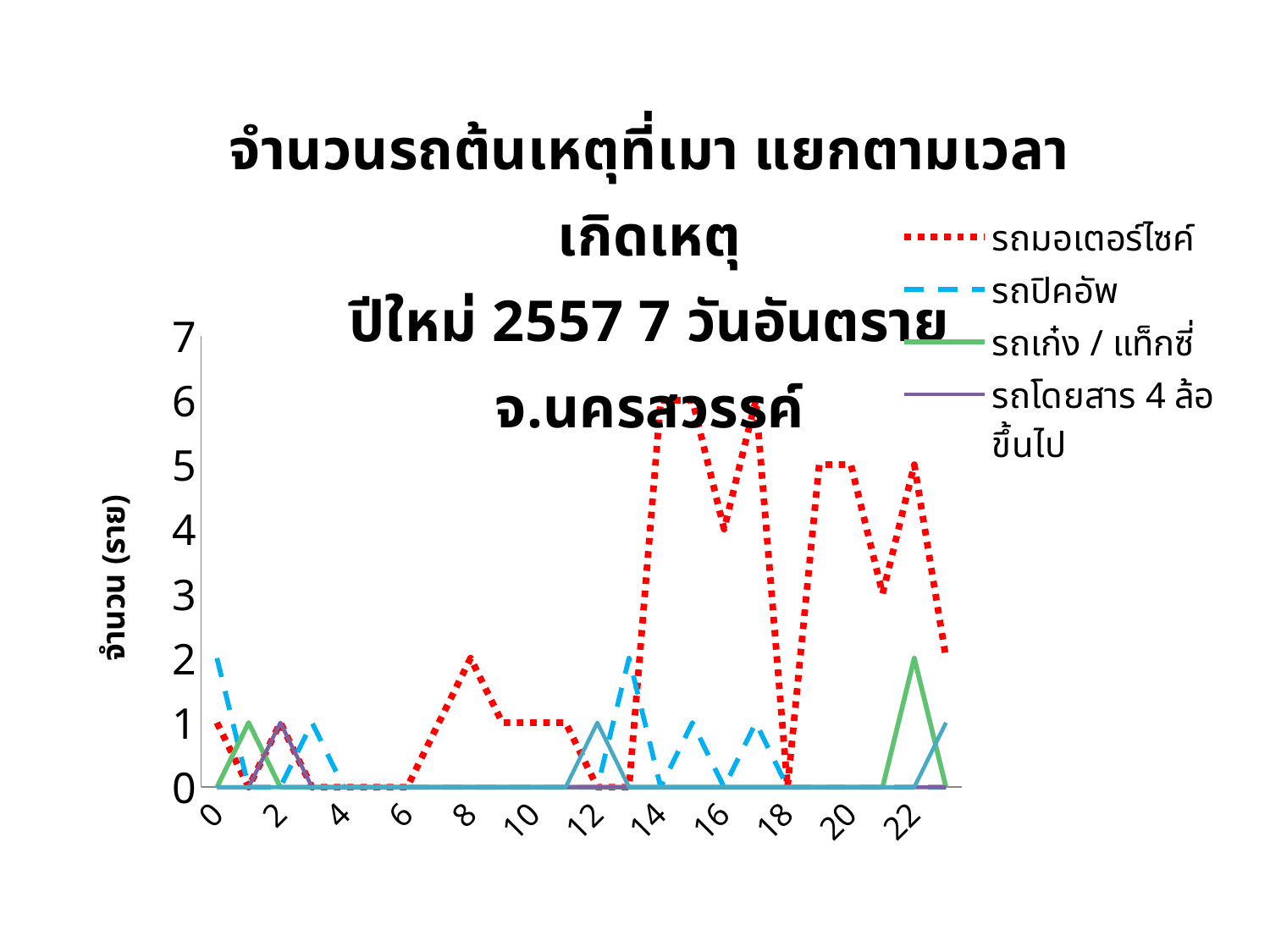
Which series reaches the highest value on the chart? รถมอเตอร์ไซค์ What is the value for รถมอเตอร์ไซค์ at hour 8? 2 How many series does the legend list? 4 What kind of chart is shown on the slide? line chart Which is larger at hour 22: รถมอเตอร์ไซค์ or รถเก๋ง / แท็กซี่? รถมอเตอร์ไซค์ What is the value for รถมอเตอร์ไซค์ at hour 21? 3 What is the value for รถเก๋ง / แท็กซี่ at hour 22? 2 Is the value for รถมอเตอร์ไซค์ at hour 14 greater or less than 5? greater What is the label of the vertical axis? จำนวน (ราย) What is the difference between รถมอเตอร์ไซค์ at hour 16 and at hour 21? 1 What is the value for รถมอเตอร์ไซค์ at hour 16? 4 What is the value for รถปิคอัพ at hour 0? 2